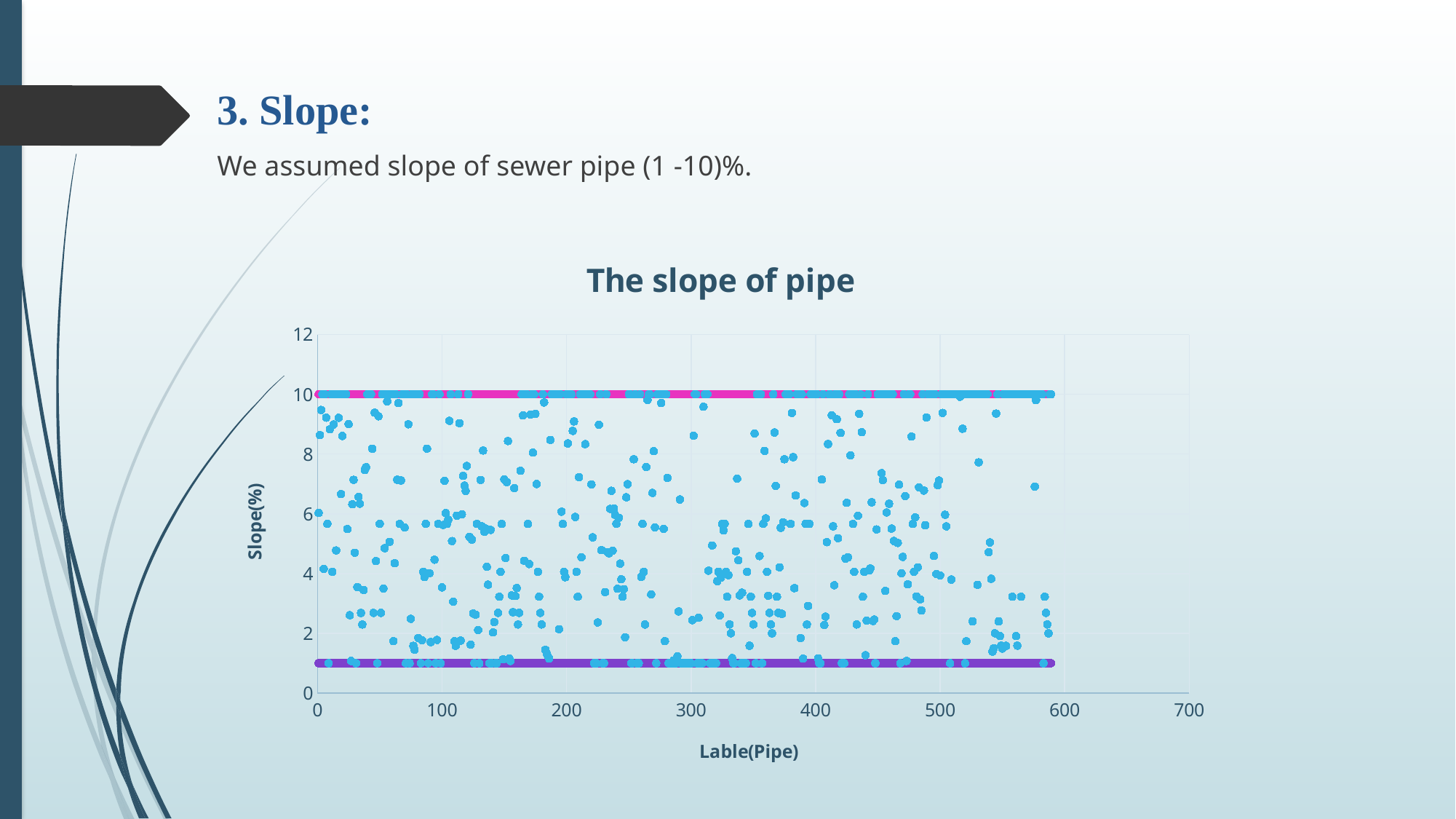
At what Slope(%) value does the upper horizontal line of points sit? 10 What is the highest value shown on the horizontal axis of the chart? 700 Is the upper horizontal line of points greater or less than 8 on the Slope(%) axis? greater What kind of chart is shown on the slide? scatter chart Are the scattered points in the chart all less than or greater than 12 on the Slope(%) axis? less What is the title of the chart? The slope of pipe What is the label of the vertical axis of the chart? Slope(%) Is the lower horizontal line of points greater or less than 2 on the Slope(%) axis? less What is the highest value shown on the vertical axis of the chart? 12